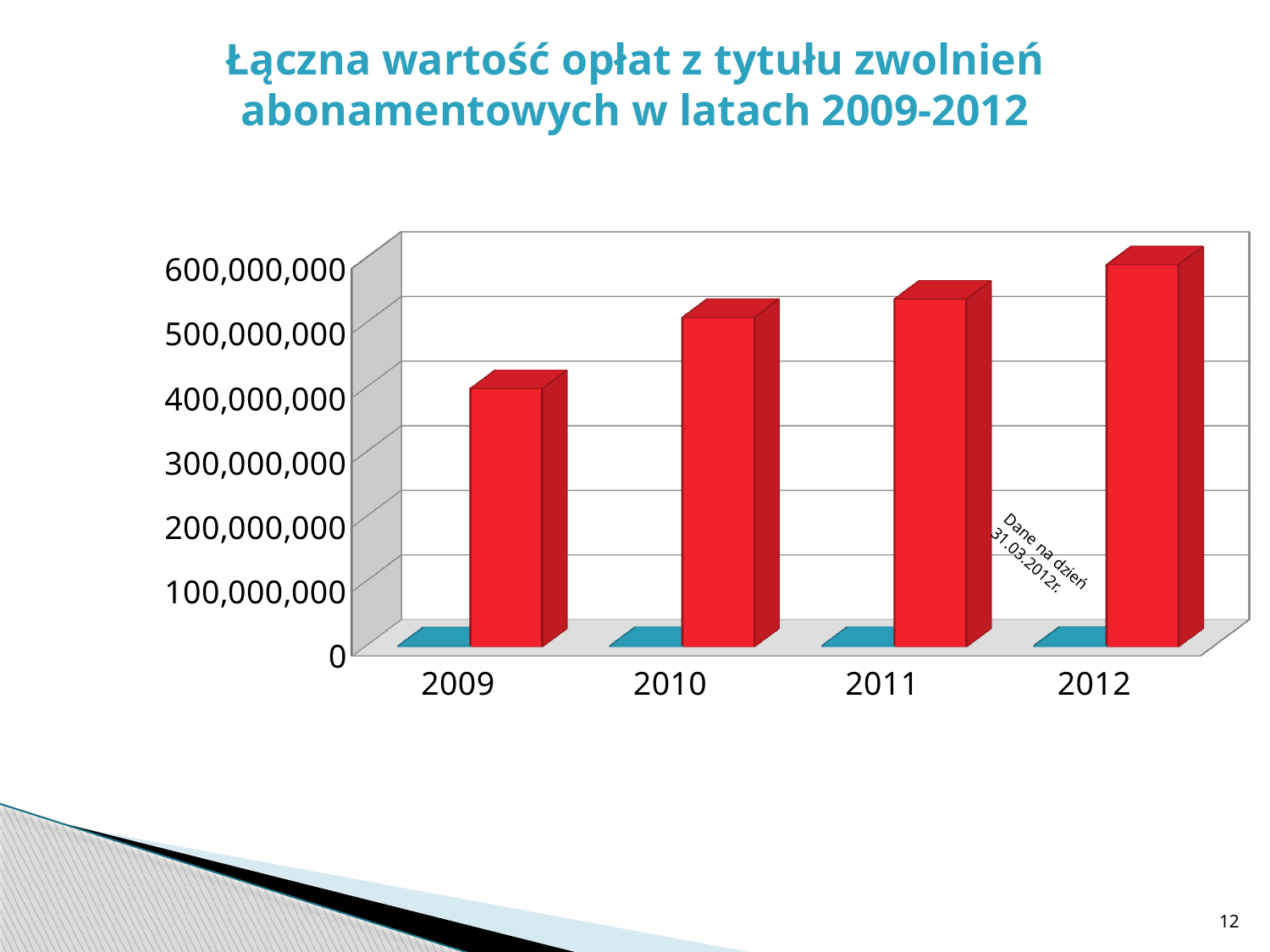
Which is larger, the value for 2009 or the value for 2012? 2012 Is the value for 2012 greater or less than 500,000,000? greater How many years are shown on the x axis of the chart? 4 What date is given in the note on the chart ("Dane na dzień")? 31.03.2012r. Which is larger, the value for 2011 or the value for 2010? 2011 Which year has the highest value in the chart? 2012 Is the value for 2011 greater or less than 500,000,000? greater Which year has the lowest value in the chart? 2009 Is the value for 2010 greater or less than 400,000,000? greater Do the values rise or fall from 2009 to 2012? rise What kind of chart is shown on the slide? bar chart